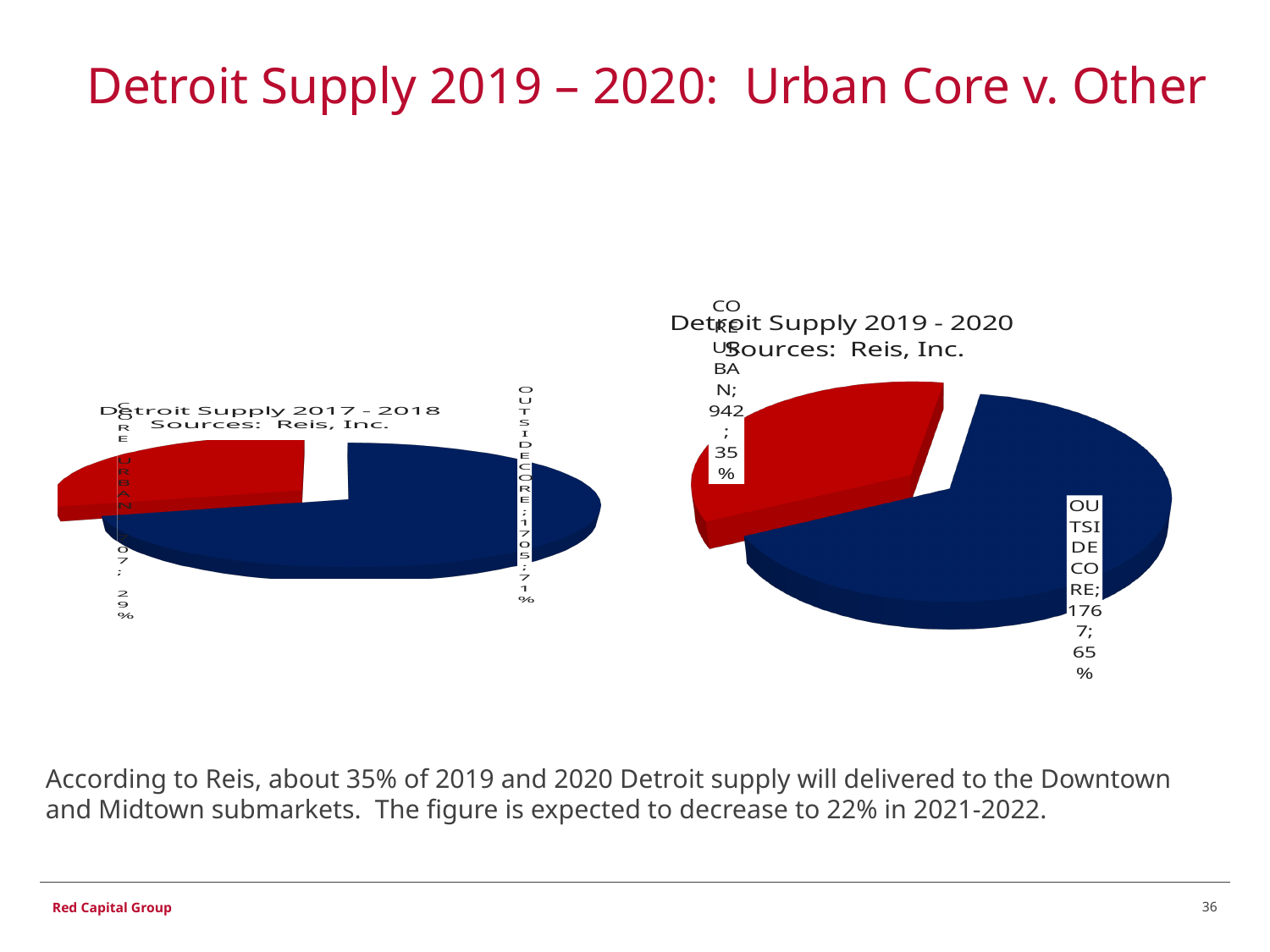
In the Detroit Supply 2017 - 2018 chart, what value is shown for OUTSIDE CORE? 1705 In the Detroit Supply 2019 - 2020 chart, what share of the pie does CORE URBAN represent? 35% In the Detroit Supply 2019 - 2020 chart, which slice is the largest? OUTSIDE CORE In the Detroit Supply 2019 - 2020 chart, what value is shown for CORE URBAN? 942 In the Detroit Supply 2017 - 2018 chart, what share of the pie does CORE URBAN represent? 29% Which is larger: the CORE URBAN value in the 2017 - 2018 chart or the CORE URBAN value in the 2019 - 2020 chart? 2019 - 2020 In the Detroit Supply 2019 - 2020 chart, what is the difference between the OUTSIDE CORE and CORE URBAN values? 825 In the Detroit Supply 2017 - 2018 chart, which slice is the smallest? CORE URBAN In the Detroit Supply 2019 - 2020 chart, what value is shown for OUTSIDE CORE? 1767 What kind of chart is the Detroit Supply 2019 - 2020 chart? Pie chart How many slices does the Detroit Supply 2017 - 2018 pie chart have? 2 In the Detroit Supply 2019 - 2020 chart, what share of the pie does OUTSIDE CORE represent? 65%